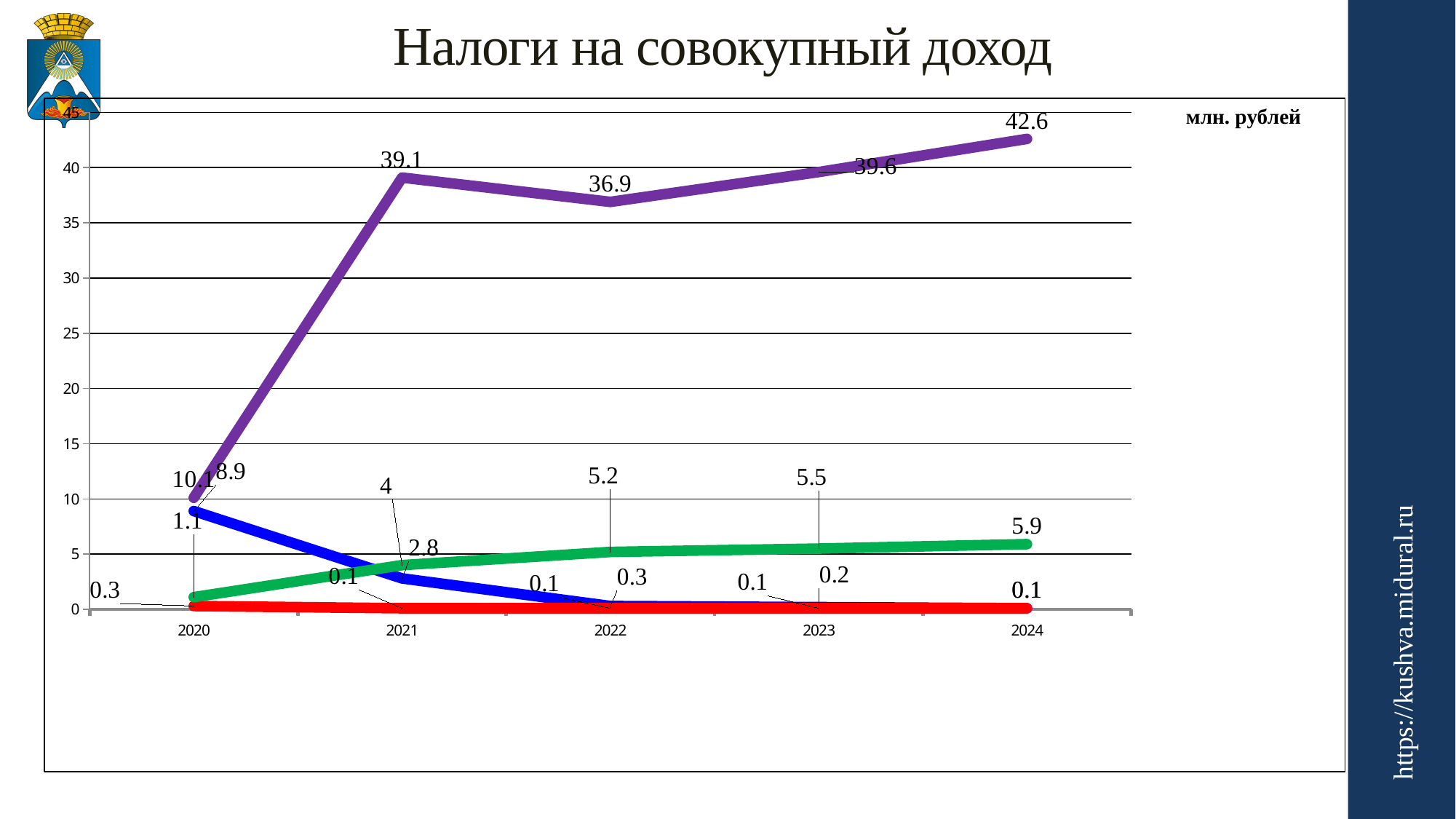
In which year does the purple line have its lowest value? 2020 What is the title of the chart? Налоги на совокупный доход How many years are shown on the x axis? 5 What is the value of the blue line in 2020? 8.9 Does the green line rise or fall from 2020 to 2024? rise In which year does the purple line reach its highest value? 2024 What is the value of the purple line in 2024? 42.6 What is the value of the green line in 2024? 5.9 What is the value of the purple line in 2021? 39.1 What type of chart is shown on the slide? line chart Which is larger for the purple line: the value in 2021 or in 2023? 2023 What is the difference between the purple line's values in 2024 and 2020? 32.5